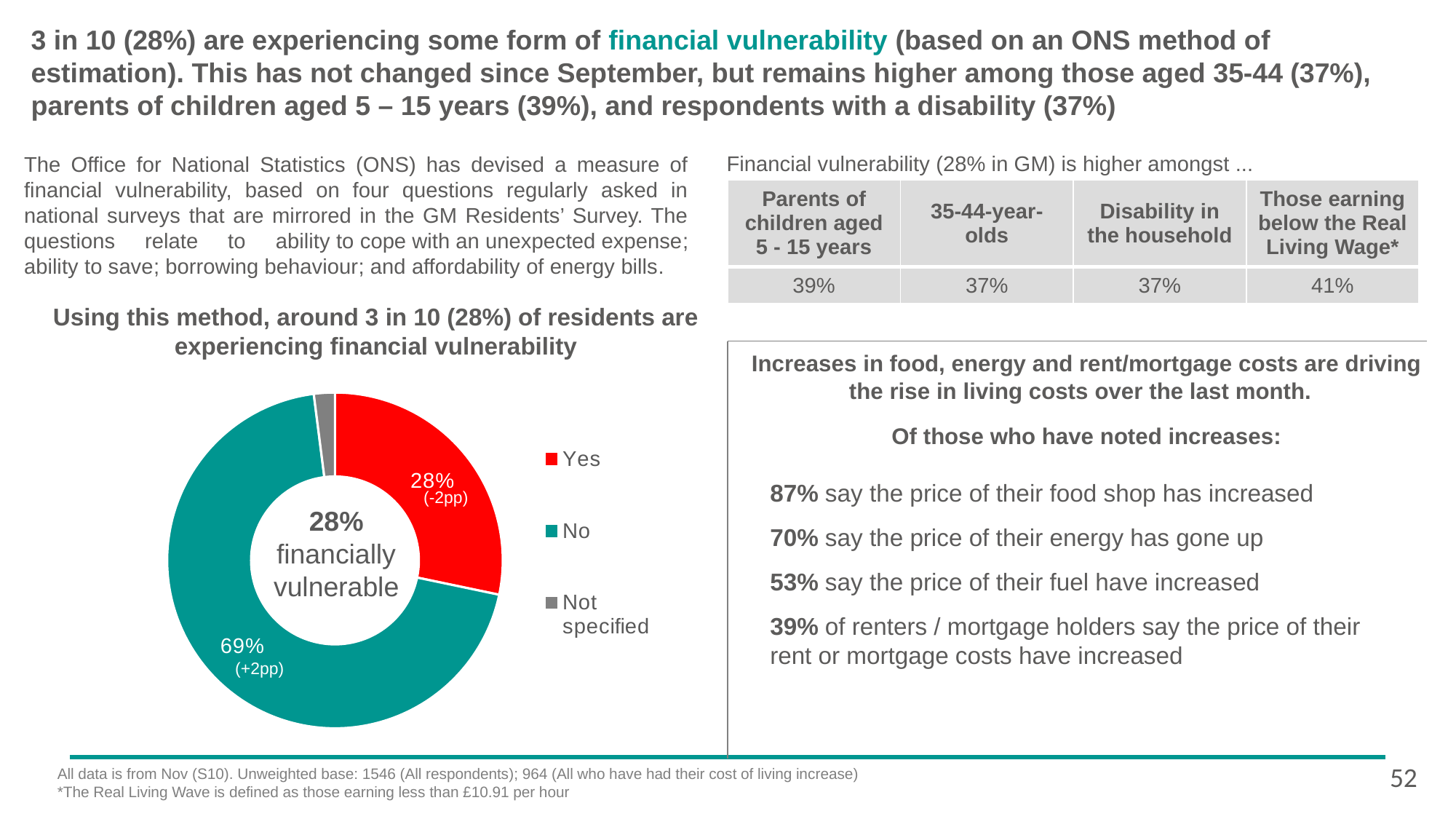
What change since the previous wave is shown next to the "Yes" slice? -2pp What kind of chart is shown on the slide? Pie chart (donut) Which slice is larger, "Yes" or "No"? No What colour is the "Yes" slice in the pie chart? Red What is the difference in percentage points between the "No" and "Yes" slices? 41 percentage points How many categories does the legend of the pie chart list? 3 What text is shown in the centre of the donut chart? 28% financially vulnerable Which category has the largest share of the pie chart? No What percentage of residents answered "No" in the financial vulnerability chart? 69% What percentage of residents answered "Yes" in the financial vulnerability chart? 28% What change since the previous wave is shown next to the "No" slice? +2pp Which category has the smallest share of the pie chart? Not specified